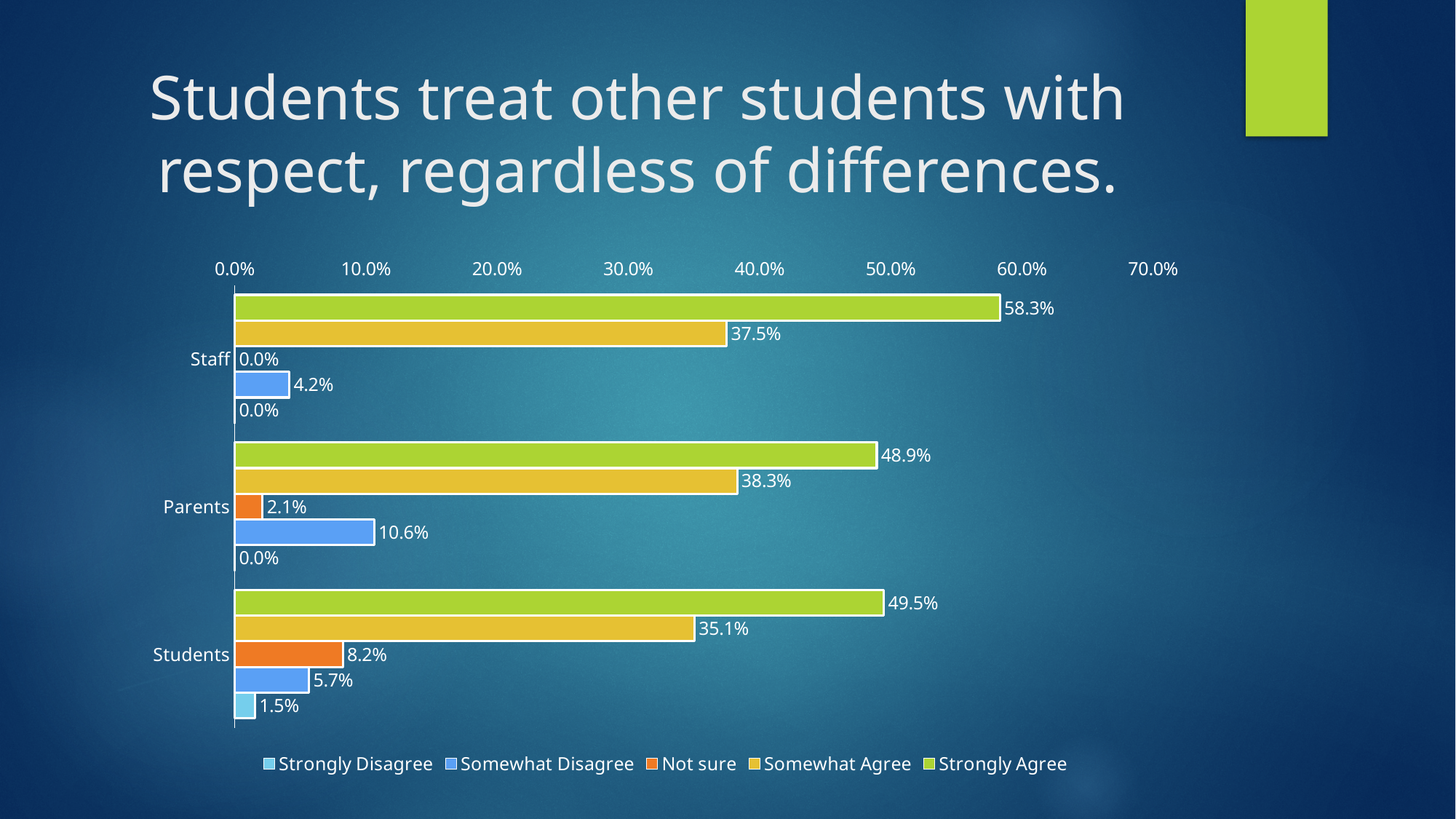
Which is larger: the Somewhat Agree value for Parents or for Staff? Parents What kind of chart is shown on the slide? Bar chart Which group has the lowest Somewhat Agree value? Students How many series does the legend list? 5 What is the Strongly Disagree value for Students? 1.5% What is the Not sure value for Students? 8.2% Which group has the highest Strongly Agree value? Staff What is the Somewhat Disagree value for Parents? 10.6% What is the Strongly Agree value for Staff? 58.3% How many groups are shown on the vertical axis? 3 Which legend entry is shown in green? Strongly Agree What is the difference between the Strongly Agree values for Staff and Parents? 9.4%